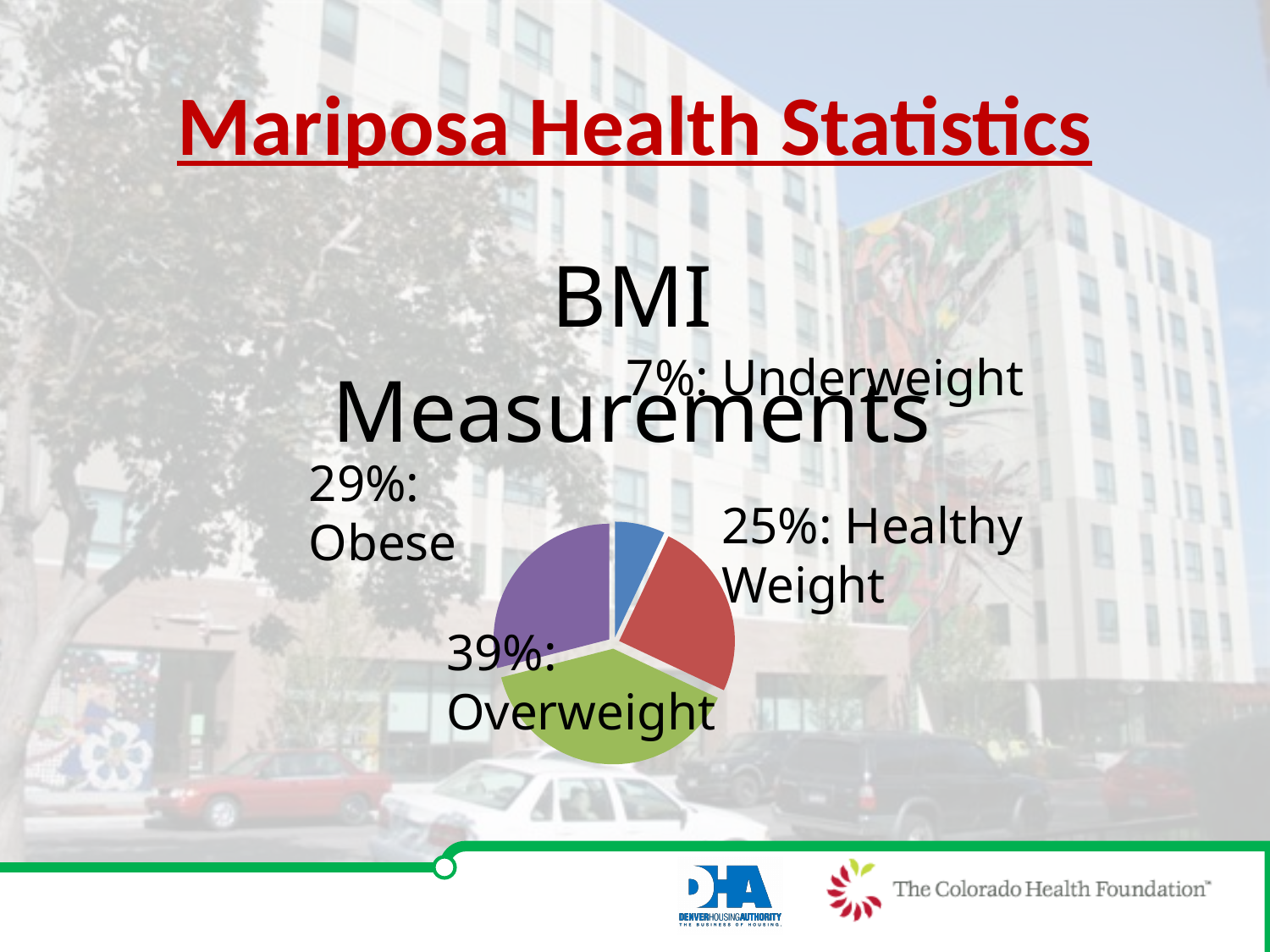
What kind of chart is shown on the slide? Pie chart What percentage of the pie is labelled Healthy Weight? 25% What is the difference in percentage points between the Overweight and Obese slices? 10 How many slices does the pie chart have? 4 What is the title of the chart? BMI Measurements Which is larger, the Healthy Weight slice or the Obese slice? Obese What percentage of the pie is labelled Underweight? 7% What percentage of the pie is labelled Obese? 29% What percentage of the pie is labelled Overweight? 39% What colour is the Overweight slice of the pie? Green Which BMI category has the smallest share of the pie? Underweight Which BMI category has the largest share of the pie? Overweight